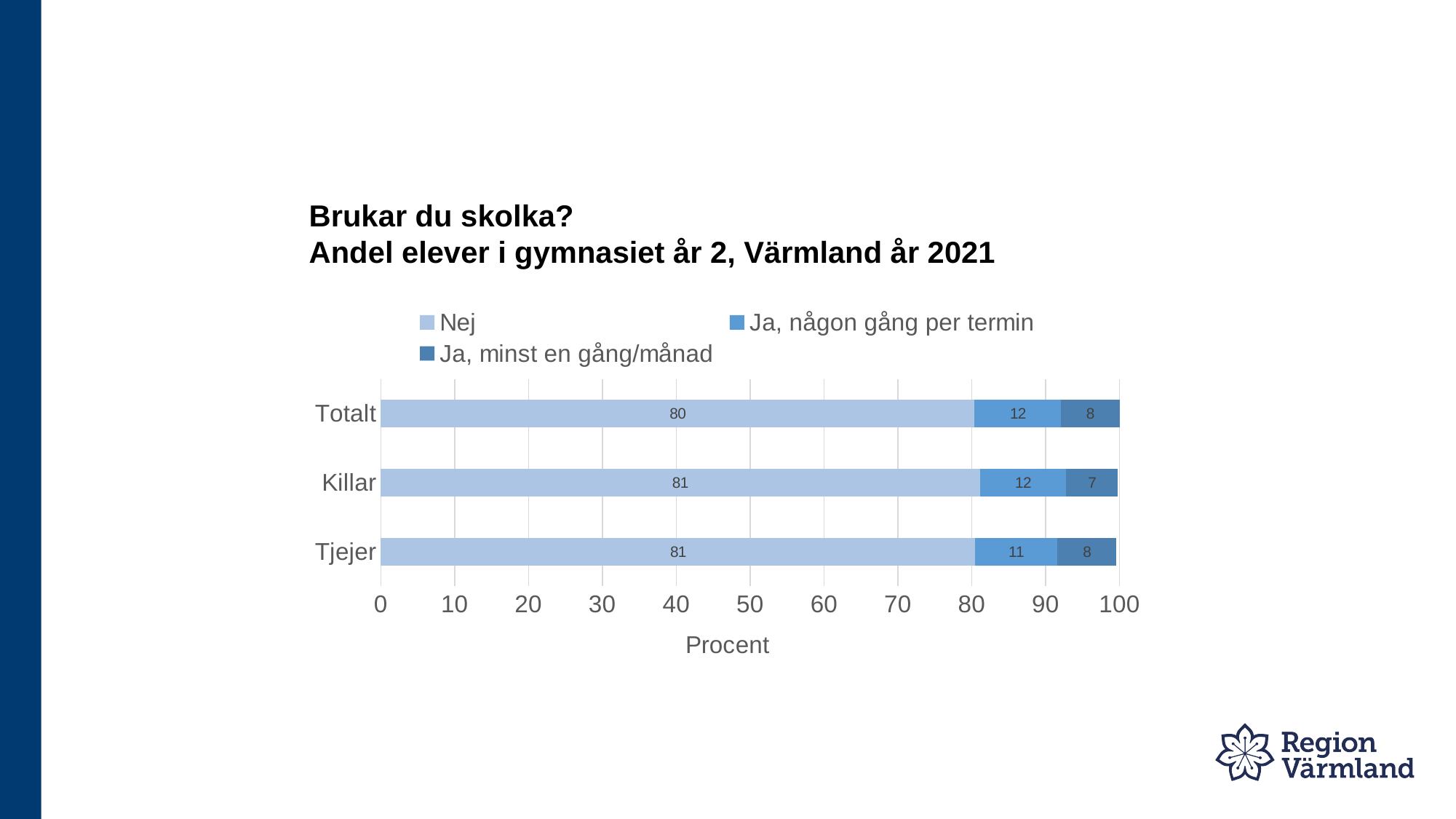
How many categories are shown on the vertical axis? 3 What kind of chart is shown on the slide? Stacked bar chart What is the value of "Ja, minst en gång/månad" for Killar? 7 Which category has the lowest "Nej" value? Totalt What is the difference between the "Ja, någon gång per termin" values for Killar and Tjejer? 1 What is the label of the horizontal axis? Procent What is the value of "Nej" for Killar? 81 How many series does the legend list? 3 What is the value of "Nej" for Totalt? 80 What is the value of "Ja, någon gång per termin" for Tjejer? 11 What is the total of the stacked bar for Totalt? 100 Which is larger: the "Ja, minst en gång/månad" value for Tjejer or for Killar? Tjejer